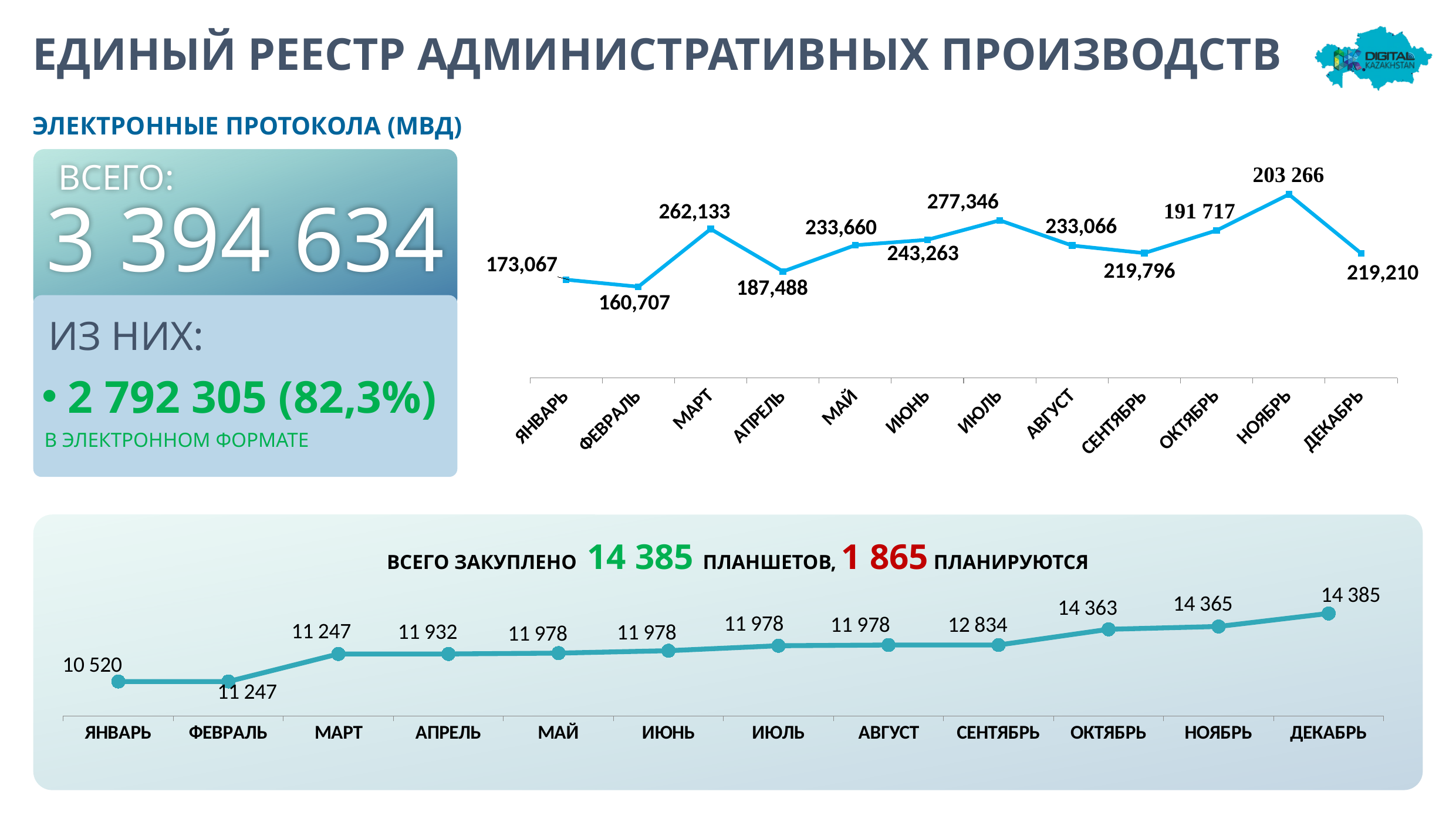
In the top chart (electronic protocols by month), what is the difference between the January value (173,067) and the February value (160,707)? 12,360 In the bottom chart (tablets purchased), what is the value for ОКТЯБРЬ (October)? 14 363 In the top chart (electronic protocols by month), what is the value for МАРТ (March)? 262,133 In the bottom chart (tablets purchased), do the values generally rise or fall from January to December? rise What kind of chart is the top chart showing electronic protocols by month? line chart In the top chart (electronic protocols by month), what is the value for ФЕВРАЛЬ (February)? 160,707 In the bottom chart (tablets purchased), what is the difference between the December value (14 385) and the January value (10 520)? 3 865 How many months are plotted in the top chart (electronic protocols)? 12 In the bottom chart (tablets purchased), what is the value for ЯНВАРЬ (January)? 10 520 In the bottom chart (tablets purchased), which month has the lowest value? ЯНВАРЬ In the bottom chart (tablets purchased), which is larger: the value for СЕНТЯБРЬ or the value for АВГУСТ? СЕНТЯБРЬ In the bottom chart (tablets purchased), which month has the highest value? ДЕКАБРЬ